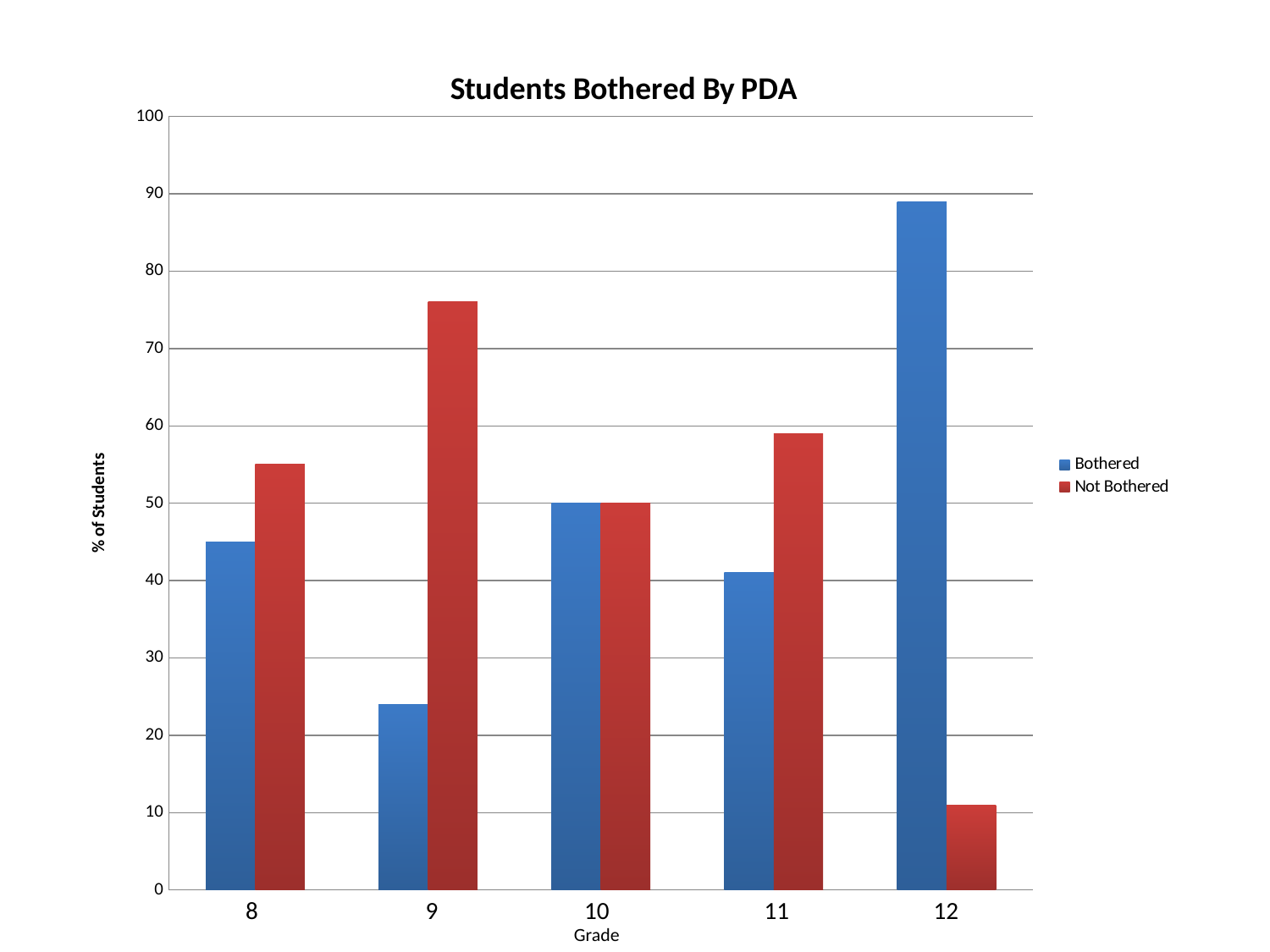
Is the Bothered value for grade 9 greater or less than 30? less For grade 11, which is larger, Bothered or Not Bothered? Not Bothered What is the title of the chart? Students Bothered By PDA What is the Bothered value for grade 10? 50 Which grade has the lowest Not Bothered value? 12 Is the Bothered value for grade 12 greater or less than 80? greater What kind of chart is shown on the slide? bar chart How many grades are shown on the x axis? 5 How many series does the legend list? 2 Which grade has the highest Not Bothered value? 9 What is the Not Bothered value for grade 10? 50 Which grade has the highest Bothered value? 12